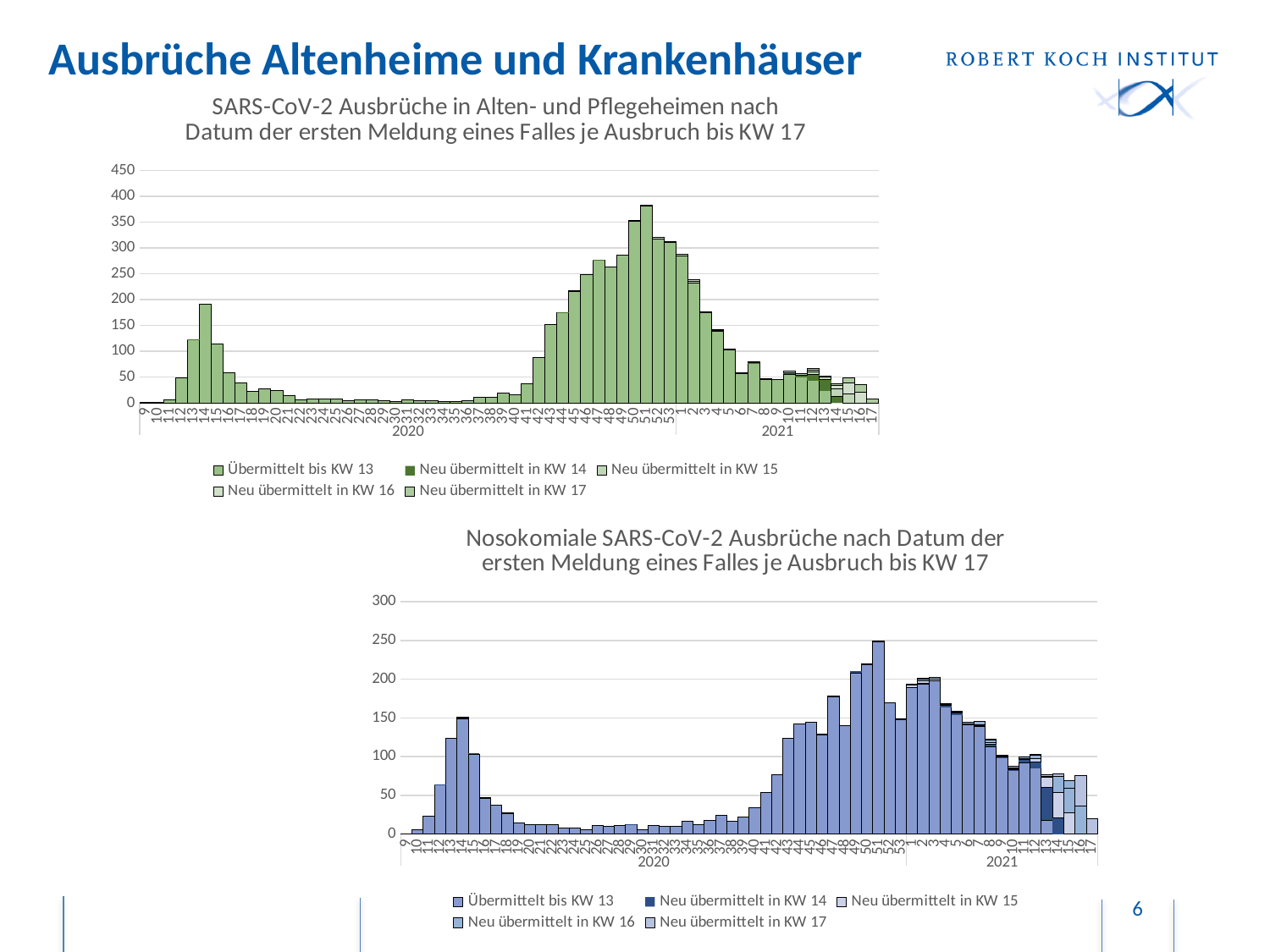
In the bottom chart (Nosokomiale Ausbrüche), which calendar week of 2020 has the highest bar? KW 51 In the top chart (Alten- und Pflegeheime), is the value for KW 30 of 2020 greater or less than 50? less In the bottom chart (Nosokomiale Ausbrüche), is the value for KW 13 of 2020 greater or less than 100? greater What is the first legend entry of the top chart (Alten- und Pflegeheime)? Übermittelt bis KW 13 How many series does the legend of the bottom chart, 'Nosokomiale SARS-CoV-2 Ausbrüche', list? 5 What kind of chart is the top chart, 'SARS-CoV-2 Ausbrüche in Alten- und Pflegeheimen'? Stacked bar chart In the top chart (Alten- und Pflegeheime), which is larger: the bar for KW 14 of 2020 or the bar for KW 51 of 2020? KW 51 of 2020 In the bottom chart (Nosokomiale Ausbrüche), is the value for KW 52 of 2020 greater or less than 200? less In the top chart (Alten- und Pflegeheime), do the values rise or fall from KW 51 of 2020 to KW 5 of 2021? fall In the bottom chart (Nosokomiale Ausbrüche), do the values rise or fall from KW 40 to KW 52 of 2020? rise In the top chart (Alten- und Pflegeheime), which calendar week of 2020 has the highest bar? KW 51